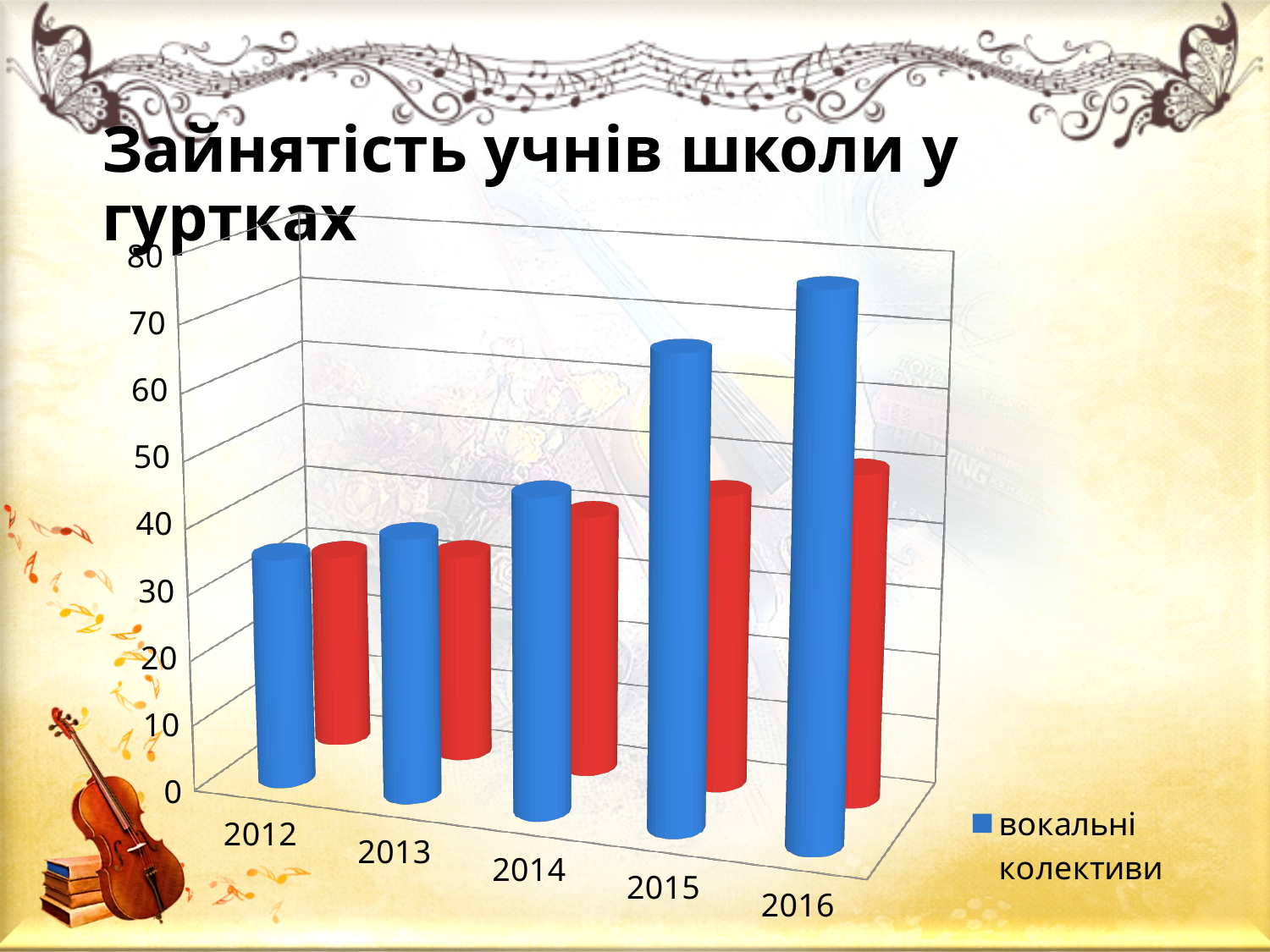
In which year is the blue bar (вокальні колективи) the highest? 2016 Is the value of the blue bar (вокальні колективи) for 2015 greater or less than 50? greater Is the value of the blue bar (вокальні колективи) for 2012 greater or less than 50? less Which year has the larger blue bar (вокальні колективи): 2012 or 2016? 2016 Which series name is shown in the chart legend? вокальні колективи Is the value of the blue bar (вокальні колективи) for 2016 greater or less than 60? greater How many years are shown on the x axis of the chart? 5 Which is larger for 2015: the blue bar or the red bar? the blue bar Do the values of the blue bars (вокальні колективи) rise or fall from 2012 to 2016? rise What is the title of the chart? Зайнятість учнів школи у гуртках What kind of chart is shown on the slide? bar chart